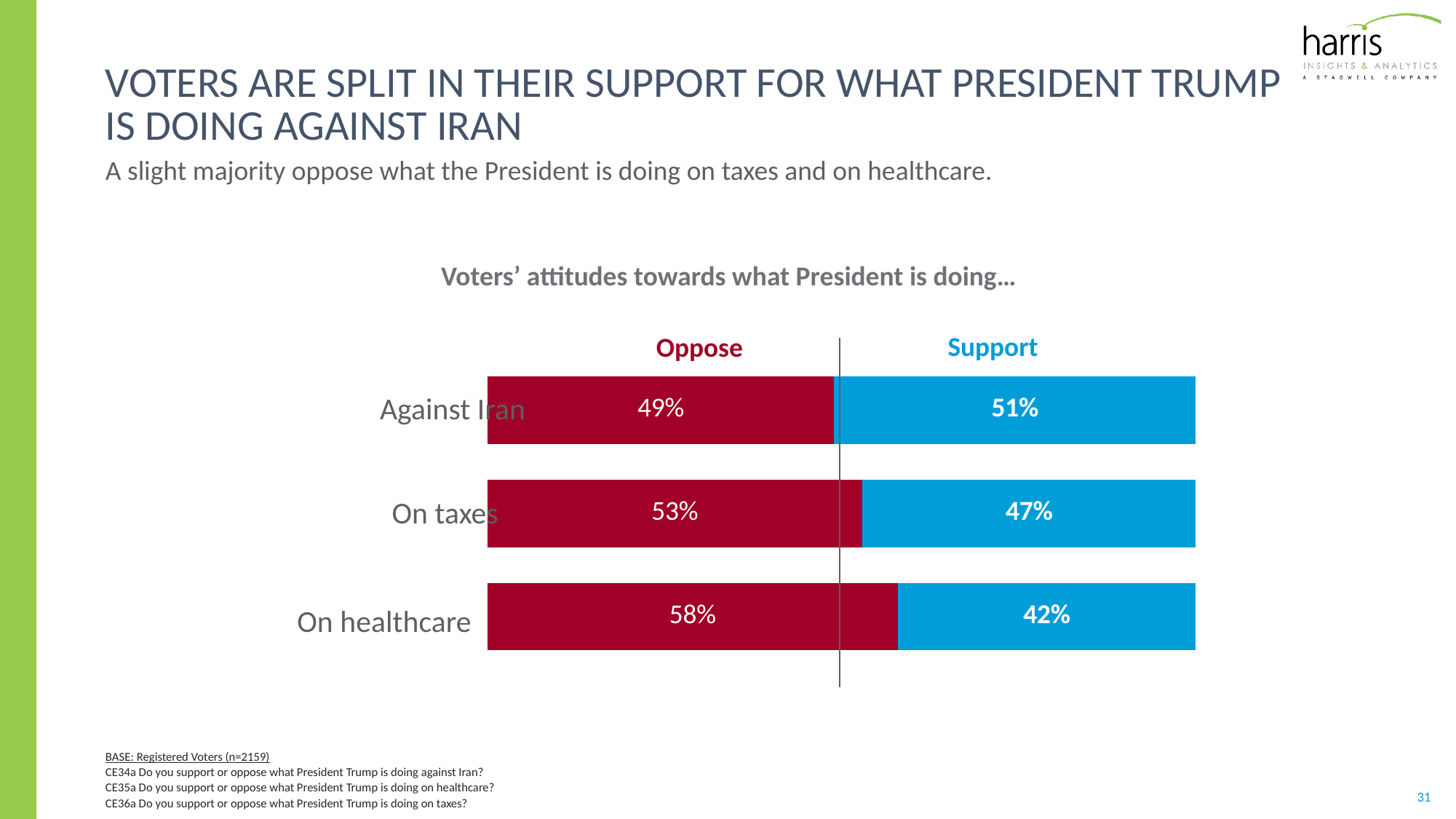
What percentage of voters support what the President is doing on taxes? 47% What is the difference between the Oppose and Support percentages for healthcare? 16% Is the Oppose percentage larger for taxes or for healthcare? On healthcare What kind of chart is shown on the slide? Bar chart What percentage of voters oppose what the President is doing on healthcare? 58% What percentage of voters support what the President is doing against Iran? 51% Which issue has the lowest Support percentage? On healthcare Which issue has the highest Oppose percentage? On healthcare What is the title of the chart? Voters' attitudes towards what President is doing... How many series does the chart show? 2 How many issues are shown in the chart? 3 What percentage of voters oppose what the President is doing against Iran? 49%